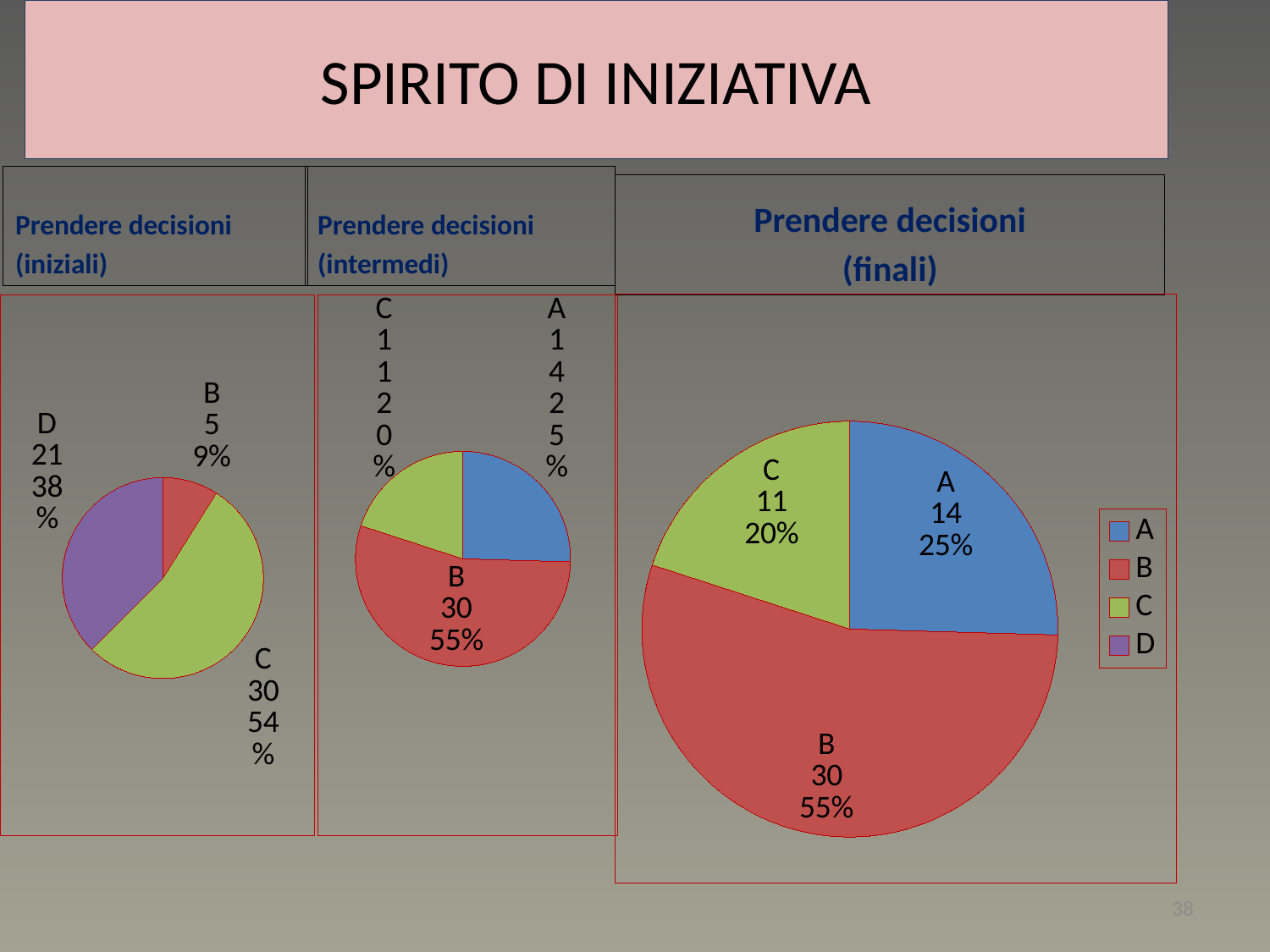
In the 'Prendere decisioni (iniziali)' chart, which category has the smallest slice? B What type of chart is 'Prendere decisioni (finali)'? Pie chart In the 'Prendere decisioni (iniziali)' chart, what value is shown for D? 21 In the 'Prendere decisioni (finali)' chart, what percentage share does slice C have? 20% In the 'Prendere decisioni (intermedi)' chart, what is the difference between the values for B and C? 19 How many entries does the legend next to the 'Prendere decisioni (finali)' chart list? 4 How many slices does the 'Prendere decisioni (iniziali)' pie chart have? 3 In the 'Prendere decisioni (iniziali)' chart, which category has the largest slice? C In the 'Prendere decisioni (finali)' chart, what value is shown for B? 30 In the 'Prendere decisioni (intermedi)' chart, what value is shown for A? 14 In the 'Prendere decisioni (iniziali)' chart, what percentage share does slice D have? 38% In the 'Prendere decisioni (finali)' chart, which is larger, the value for A or the value for C? A